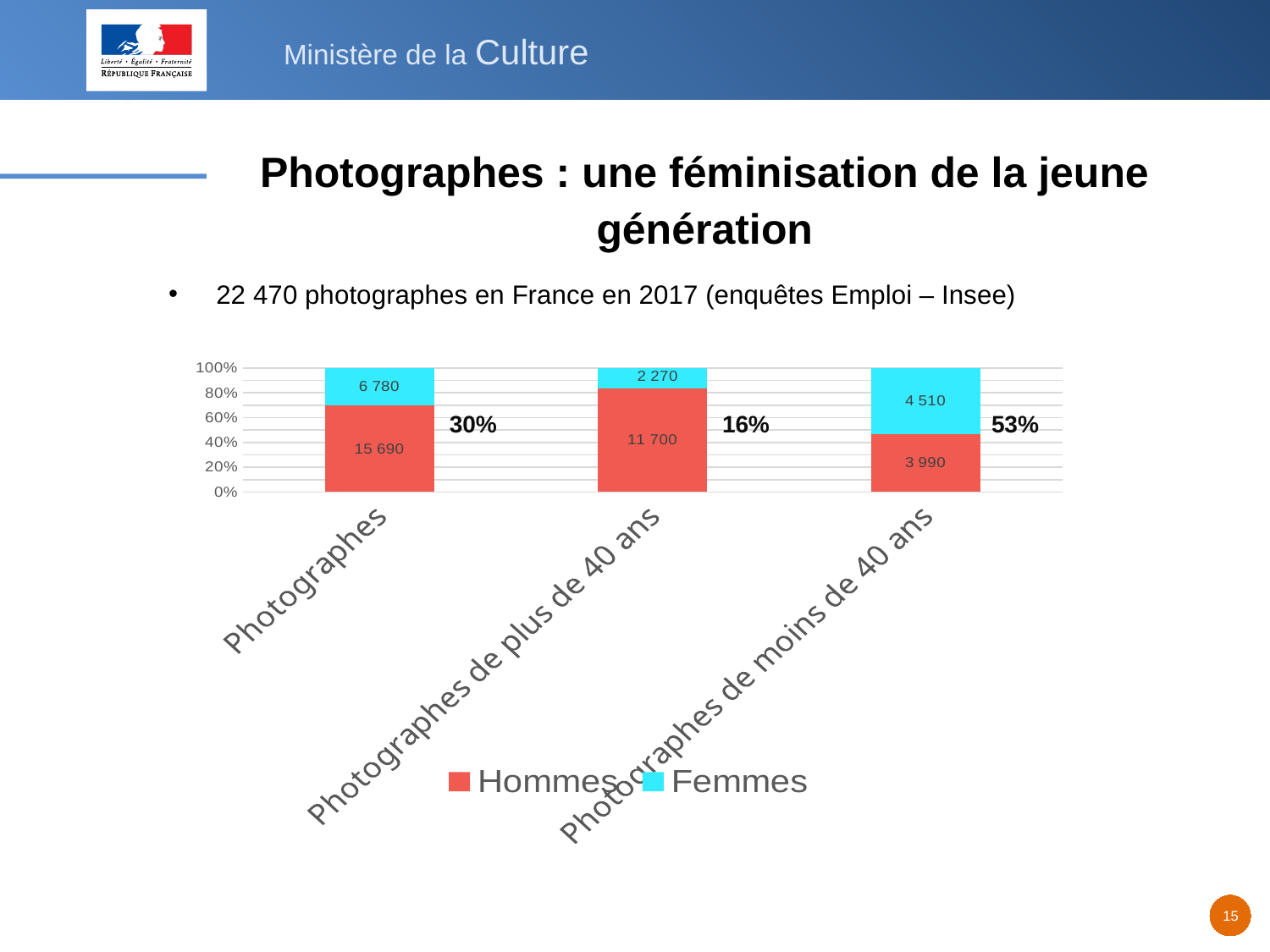
Which category has the lowest number of Femmes? Photographes de plus de 40 ans What is the difference between Hommes and Femmes for Photographes de plus de 40 ans? 9 430 How many men (Hommes) are there among all photographers (Photographes)? 15 690 What is the total of the stacked bar for Photographes de moins de 40 ans? 8 500 For Photographes de moins de 40 ans, which is larger: Hommes or Femmes? Femmes How many series does the legend list? 2 Which category has the highest number of Hommes? Photographes How many categories are shown on the x axis? 3 What percentage is annotated next to the bar for Photographes de moins de 40 ans? 53% How many women (Femmes) are there among photographers under 40 (Photographes de moins de 40 ans)? 4 510 How many women (Femmes) are there among photographers over 40 (Photographes de plus de 40 ans)? 2 270 What kind of chart is shown on the slide? Stacked bar chart